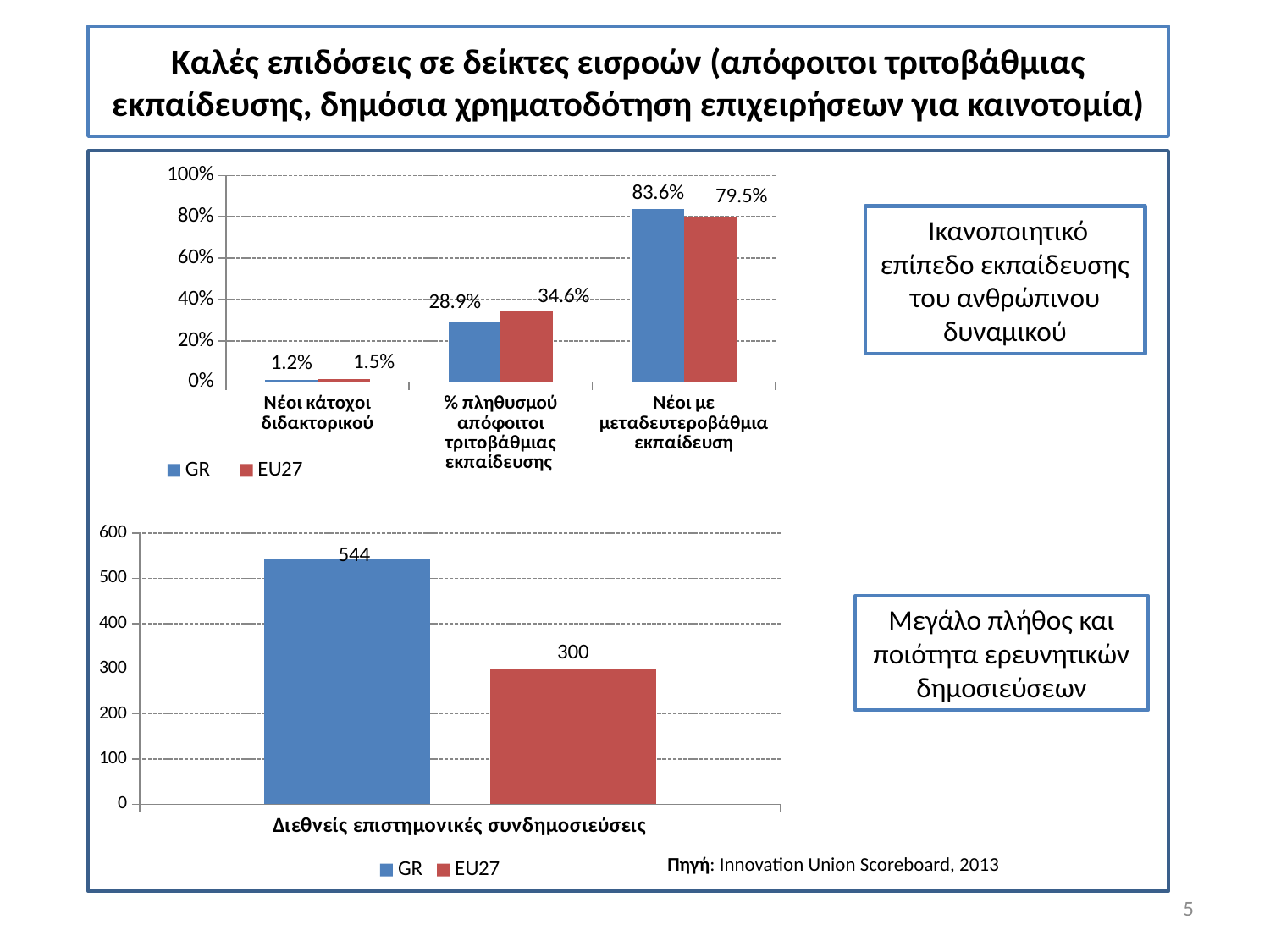
In the top chart, what is the difference between the GR and EU27 values for Νέοι με μεταδευτεροβάθμια εκπαίδευση? 4.1% In the top chart, what is the EU27 value for Νέοι κάτοχοι διδακτορικού? 1.5% What type of chart is the bottom chart? Bar chart In the top chart, which category has the lowest EU27 value? Νέοι κάτοχοι διδακτορικού In the bottom chart, what is the GR value for Διεθνείς επιστημονικές συνδημοσιεύσεις? 544 In the top chart, for % πληθυσμού απόφοιτοι τριτοβάθμιας εκπαίδευσης, which series has the larger value, GR or EU27? EU27 In the bottom chart, what is the difference between the GR and EU27 values? 244 How many series does the legend of the bottom chart list? 2 In the top chart, what is the GR value for Νέοι με μεταδευτεροβάθμια εκπαίδευση? 83.6% In the top chart, what is the EU27 value for % πληθυσμού απόφοιτοι τριτοβάθμιας εκπαίδευσης? 34.6% In the top chart, which category has the highest GR value? Νέοι με μεταδευτεροβάθμια εκπαίδευση How many categories are shown on the x axis of the top chart? 3